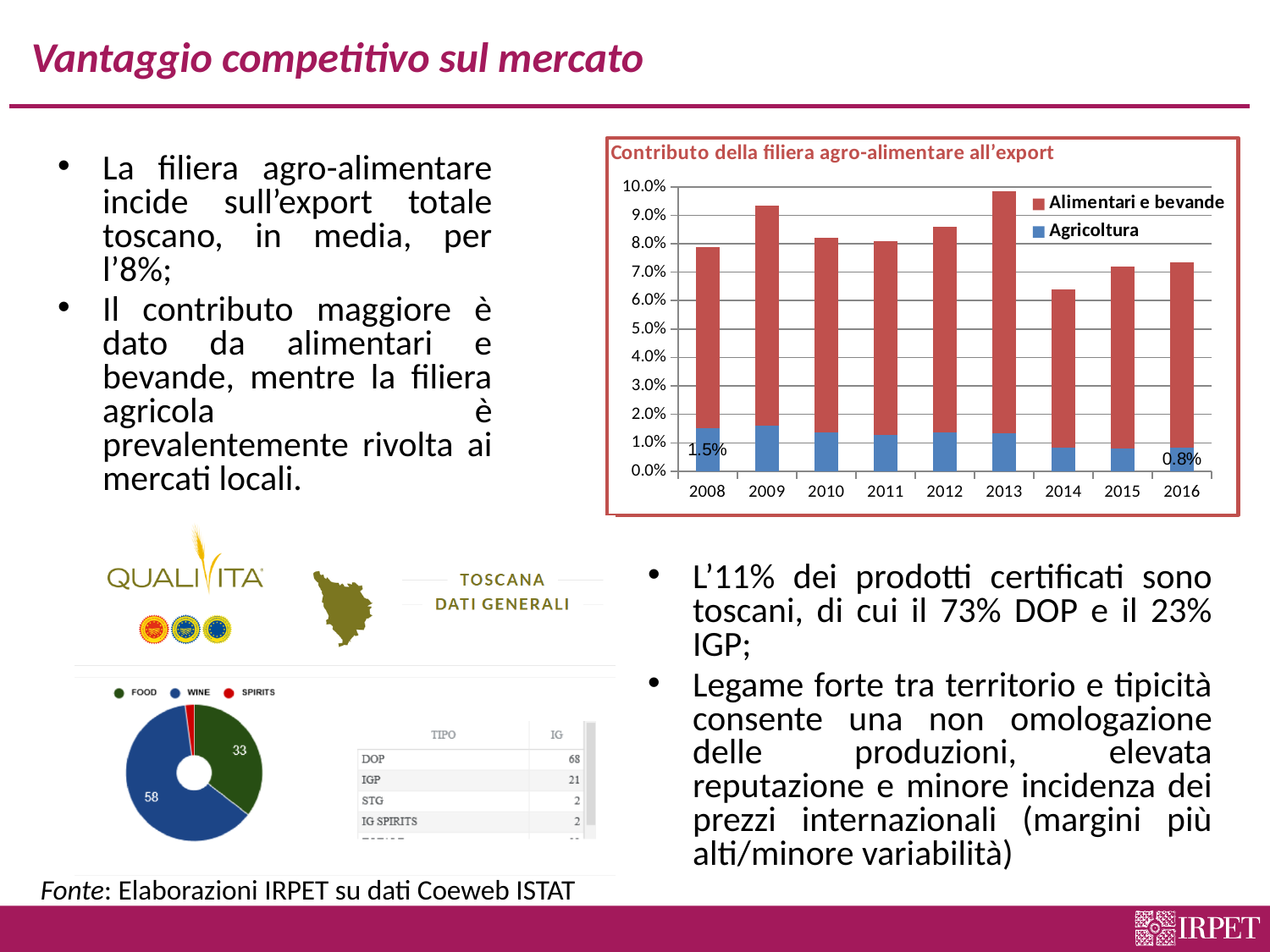
In the chart 'Contributo della filiera agro-alimentare all'export', what is the value of the Agricoltura series for 2016? 0.8% In the donut chart at the bottom left of the slide, which is larger, the FOOD slice or the WINE slice? WINE How many years are shown on the x axis of the chart 'Contributo della filiera agro-alimentare all'export'? 9 In the chart 'Contributo della filiera agro-alimentare all'export', which series is shown in red? Alimentari e bevande What kind of chart is 'Contributo della filiera agro-alimentare all'export'? Stacked bar chart In the chart 'Contributo della filiera agro-alimentare all'export', is the total bar for 2014 greater or less than 7.0%? less In the chart 'Contributo della filiera agro-alimentare all'export', what is the value of the Agricoltura series for 2008? 1.5% In the chart 'Contributo della filiera agro-alimentare all'export', which year has the highest total stacked bar? 2013 How many series does the legend of the chart 'Contributo della filiera agro-alimentare all'export' list? 2 In the chart 'Contributo della filiera agro-alimentare all'export', is the total bar for 2013 larger or smaller than the total bar for 2014? larger In the chart 'Contributo della filiera agro-alimentare all'export', is the total bar for 2013 greater or less than 9.0%? greater In the chart 'Contributo della filiera agro-alimentare all'export', which year has the lowest total stacked bar? 2014